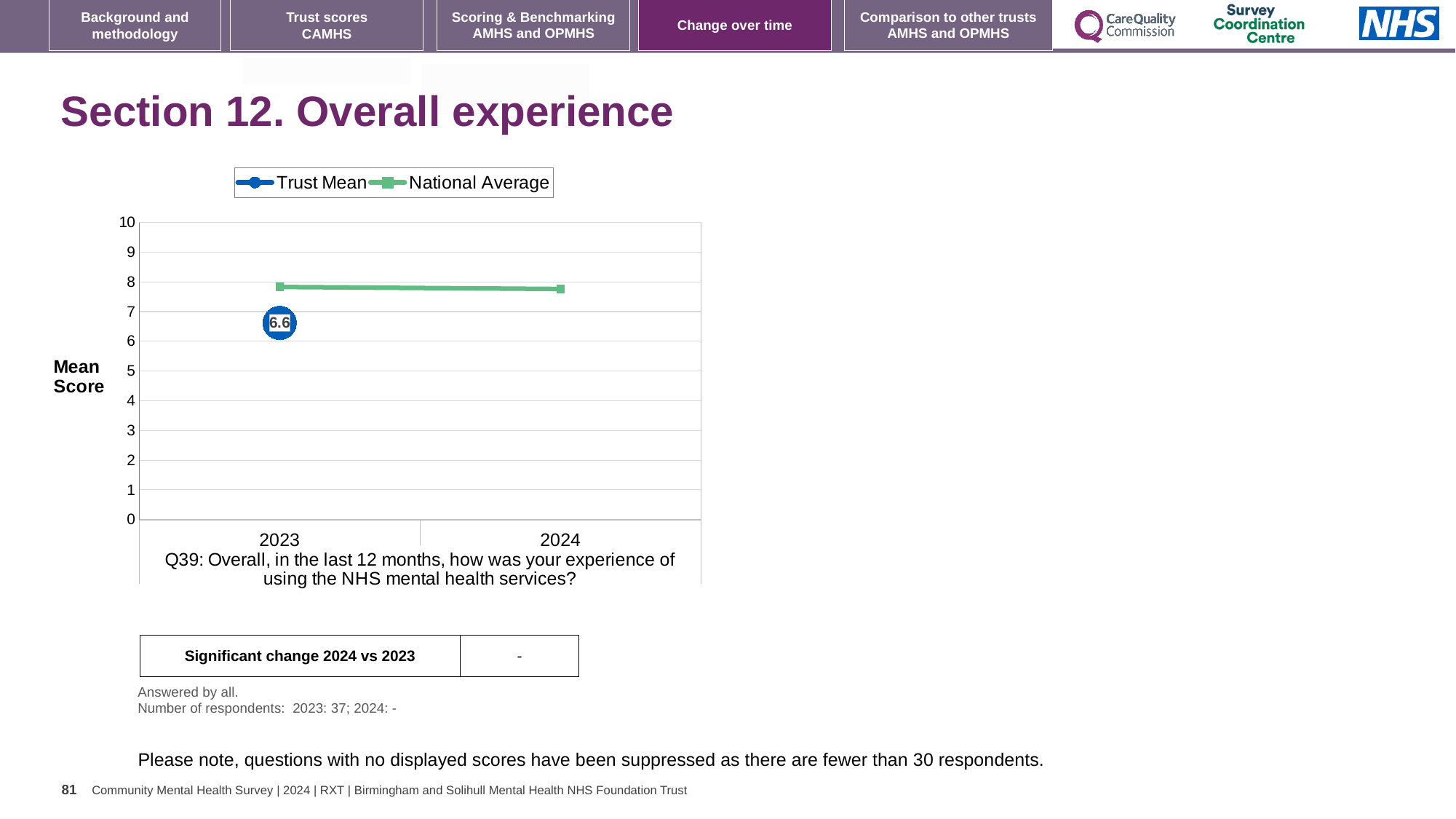
What kind of chart is shown on the slide? Line chart How many series does the legend list? 2 What is the Trust Mean value for 2023? 6.6 Is the National Average value for 2024 greater or less than 7? greater In 2023, which is higher: the Trust Mean or the National Average? National Average What are the two series named in the legend? Trust Mean and National Average Is the Trust Mean value for 2023 greater or less than 7? less How many years are shown on the x axis? 2 What is the label on the y axis of the chart? Mean Score Does the National Average line rise or fall from 2023 to 2024? Falls Is the National Average value for 2023 greater or less than 7? greater